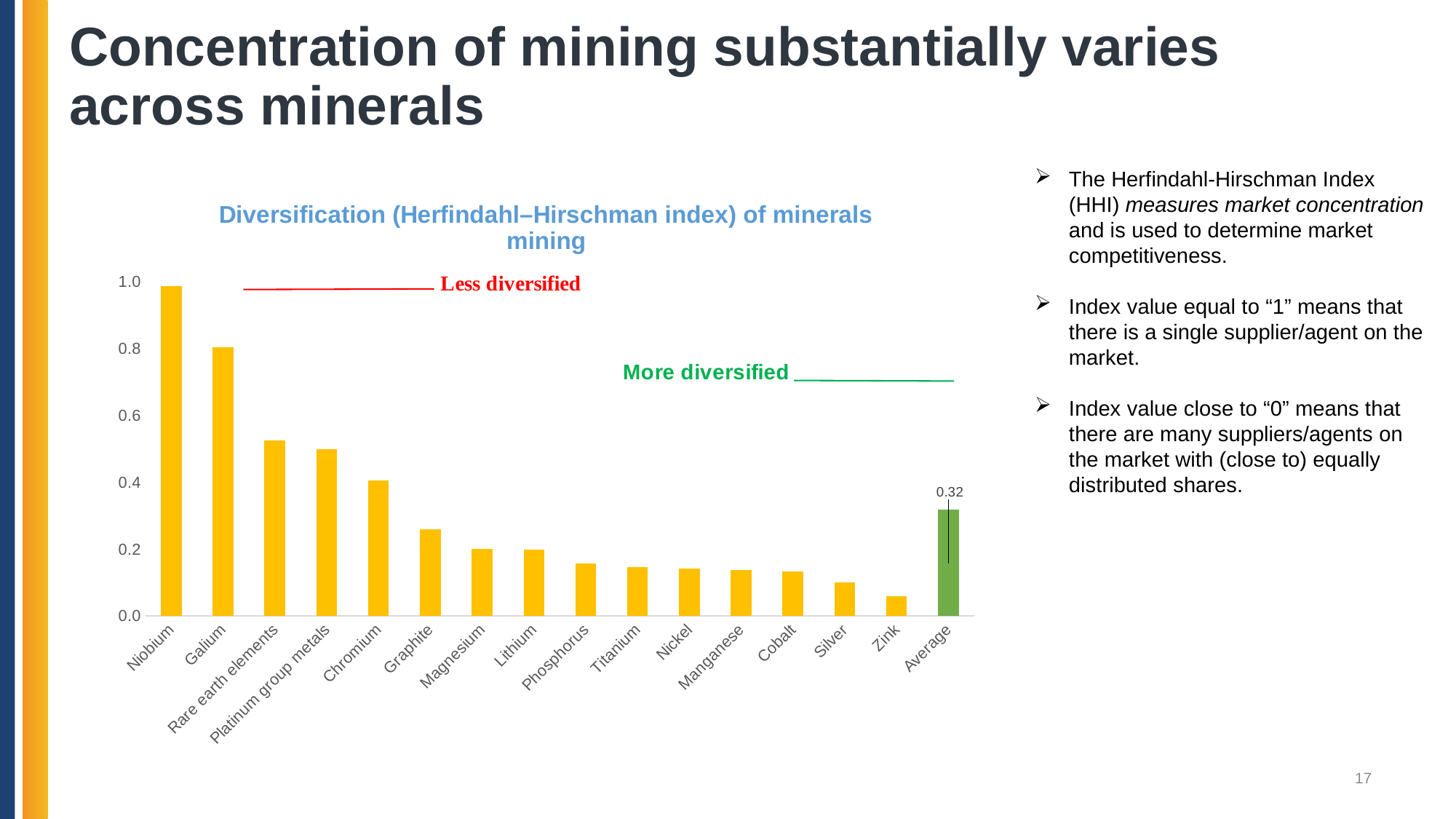
What kind of chart is shown on the slide? Bar chart Which mineral has the lowest Herfindahl–Hirschman index value? Zink Do the mineral values rise or fall from Niobium to Zink along the x axis? Fall Is the value for Graphite greater or less than 0.4? less What is the title of the chart? Diversification (Herfindahl–Hirschman index) of minerals mining Which mineral has the highest Herfindahl–Hirschman index value? Niobium Is the value for Niobium greater or less than 0.8? greater Is the value for Zink greater or less than 0.2? less What is the value shown for Average? 0.32 How many bars are plotted in the chart, including Average? 16 Which has a higher value, Galium or Chromium? Galium